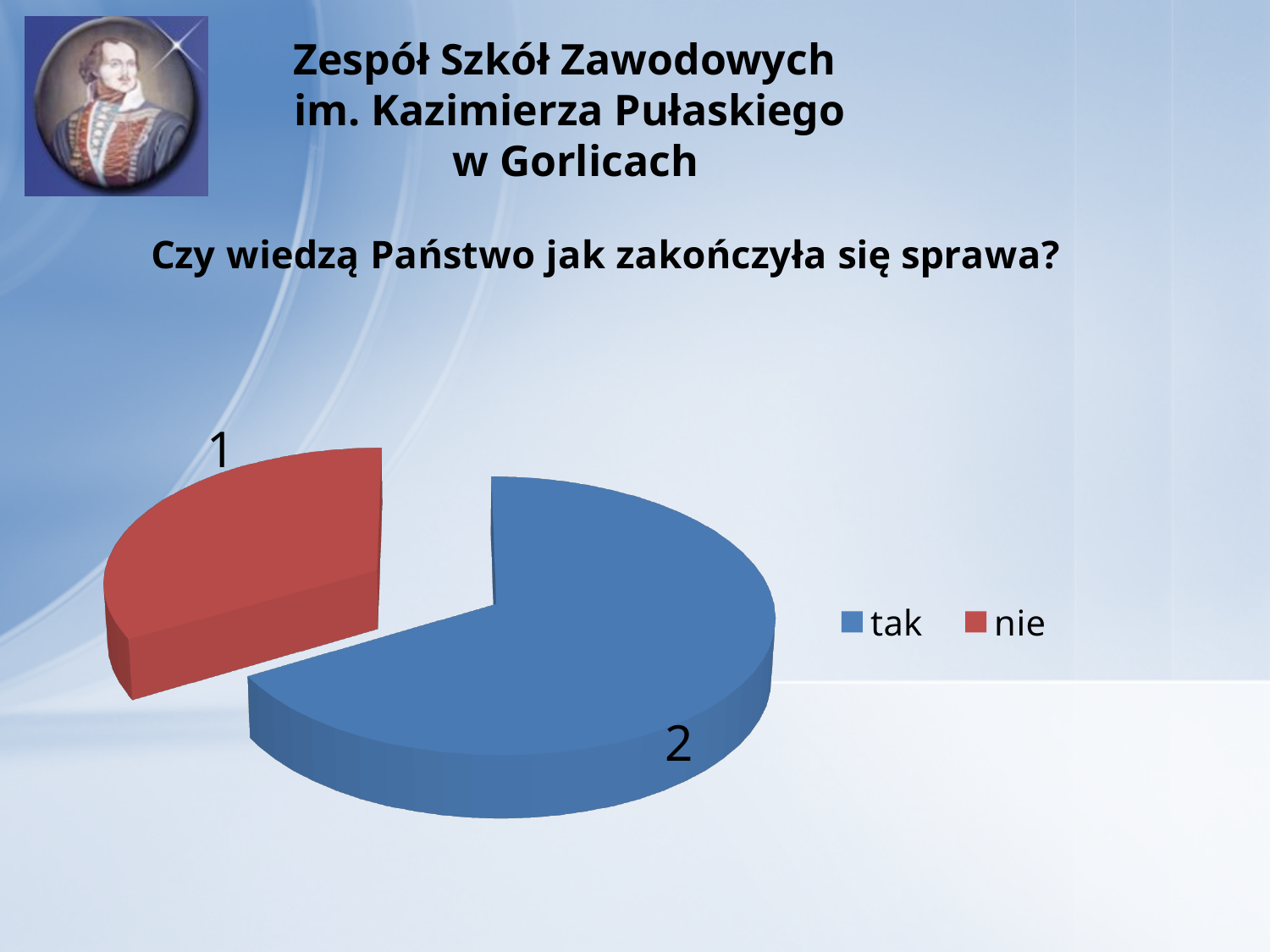
Which category has the smallest slice in the pie chart? nie How many entries does the legend list? 2 Which category has the largest slice in the pie chart? tak What is the total of all slices in the pie chart? 3 What is the difference between the values for "tak" and "nie"? 1 What colour is the "nie" slice in the pie chart? red What type of chart is shown on the slide? pie chart What question is written above the pie chart? Czy wiedzą Państwo jak zakończyła się sprawa? What is the value for "nie" in the pie chart? 1 What is the value for "tak" in the pie chart? 2 Which is larger, the value for "tak" or the value for "nie"? tak How many slices does the pie chart have? 2